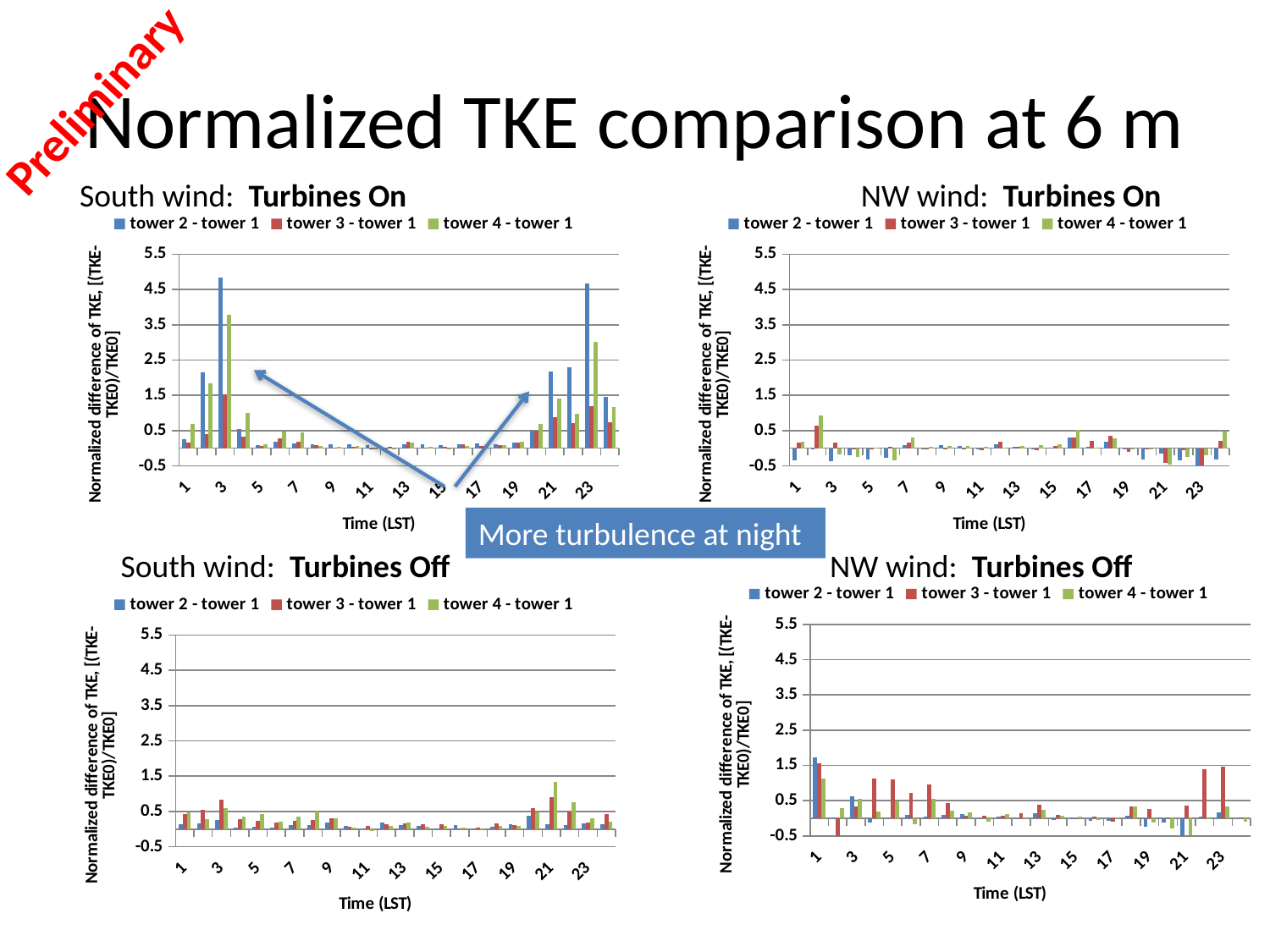
In the 'NW wind: Turbines On' chart, is the value for tower 4 - tower 1 at hour 1 greater or less than 0.5? less In the 'NW wind: Turbines Off' chart, is the value for tower 2 - tower 1 at hour 1 greater or less than 1.5? greater What type of chart is the 'South wind: Turbines On' chart? bar chart How many series does the legend of the 'NW wind: Turbines Off' chart list? 3 In the 'South wind: Turbines On' chart, is the value for tower 4 - tower 1 at hour 3 greater or less than 3.5? greater What is the x-axis label on the 'South wind: Turbines Off' chart? Time (LST) What are the three legend entries in the 'South wind: Turbines On' chart? tower 2 - tower 1, tower 3 - tower 1, tower 4 - tower 1 In the 'NW wind: Turbines Off' chart, which series has the tallest bar at hour 1? tower 2 - tower 1 In the 'South wind: Turbines On' chart, at hour 3, which is larger: tower 2 - tower 1 or tower 4 - tower 1? tower 2 - tower 1